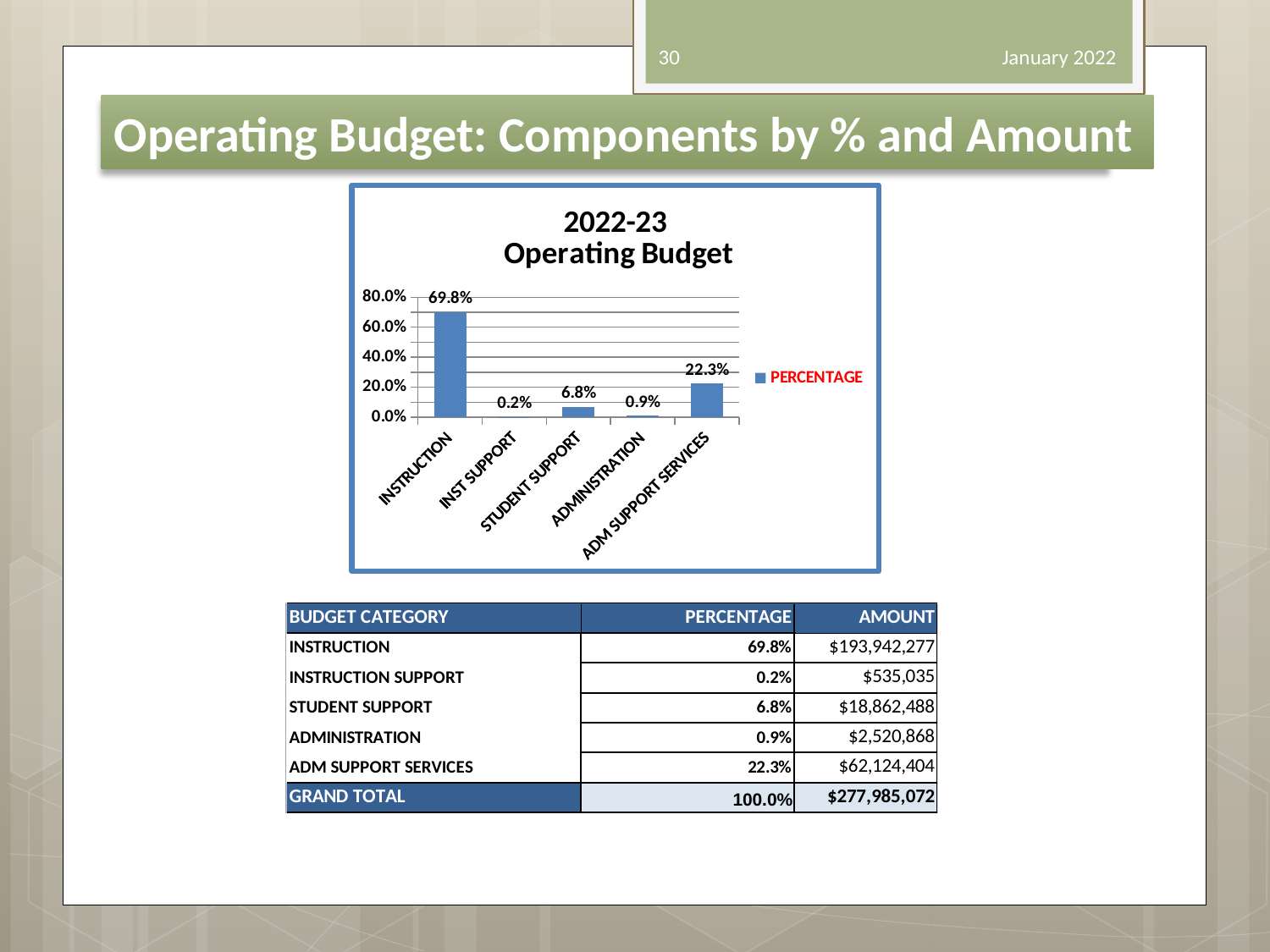
What is the value for STUDENT SUPPORT in the chart? 6.8% What kind of chart is shown on the slide? bar chart Which category has the highest value in the chart? INSTRUCTION What is the value for ADM SUPPORT SERVICES in the chart? 22.3% How many categories are shown on the x axis of the chart? 5 Is the value for INSTRUCTION greater or less than 60.0%? greater How many series does the chart legend list? 1 What is the difference between the values for INSTRUCTION and ADM SUPPORT SERVICES? 47.5% What is the value for INSTRUCTION in the 2022-23 Operating Budget chart? 69.8% Which category has the lowest value in the chart? INST SUPPORT What is the value for ADMINISTRATION in the chart? 0.9% Which is larger, the value for STUDENT SUPPORT or the value for ADMINISTRATION? STUDENT SUPPORT